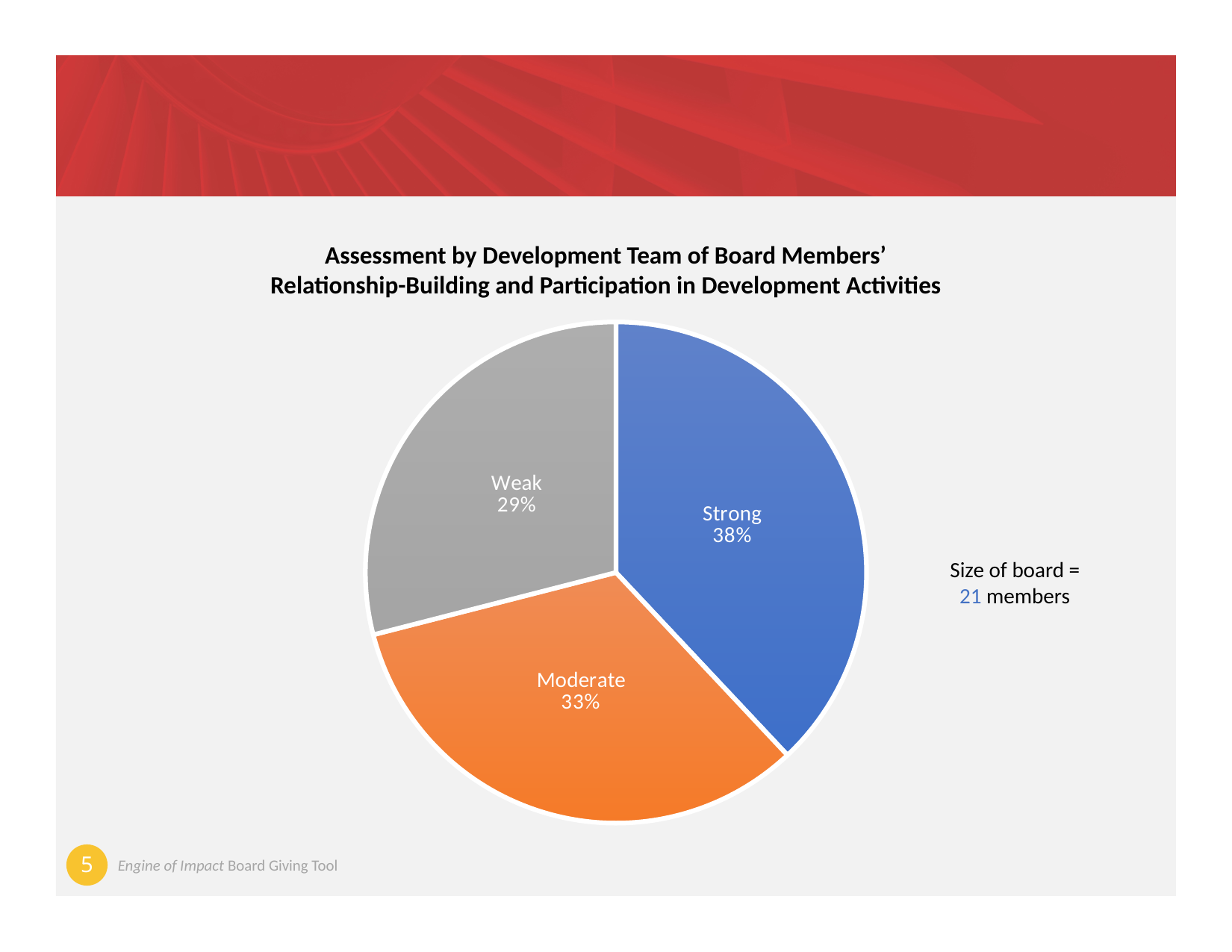
According to the note beside the chart, how many members are on the board? 21 members What type of chart is shown on the slide? Pie chart How many slices does the pie chart have? 3 Which category has the smallest share of the pie? Weak Which slice is larger, Strong or Moderate? Strong What percentage of board members are assessed as Moderate? 33% What percentage of board members are assessed as Strong? 38% What percentage of board members are assessed as Weak? 29% Which category has the largest share of the pie? Strong What is the difference in percentage points between the Moderate and Weak slices? 4 What is the difference in percentage points between the Strong and Weak slices? 9 What colour is the Moderate slice? Orange